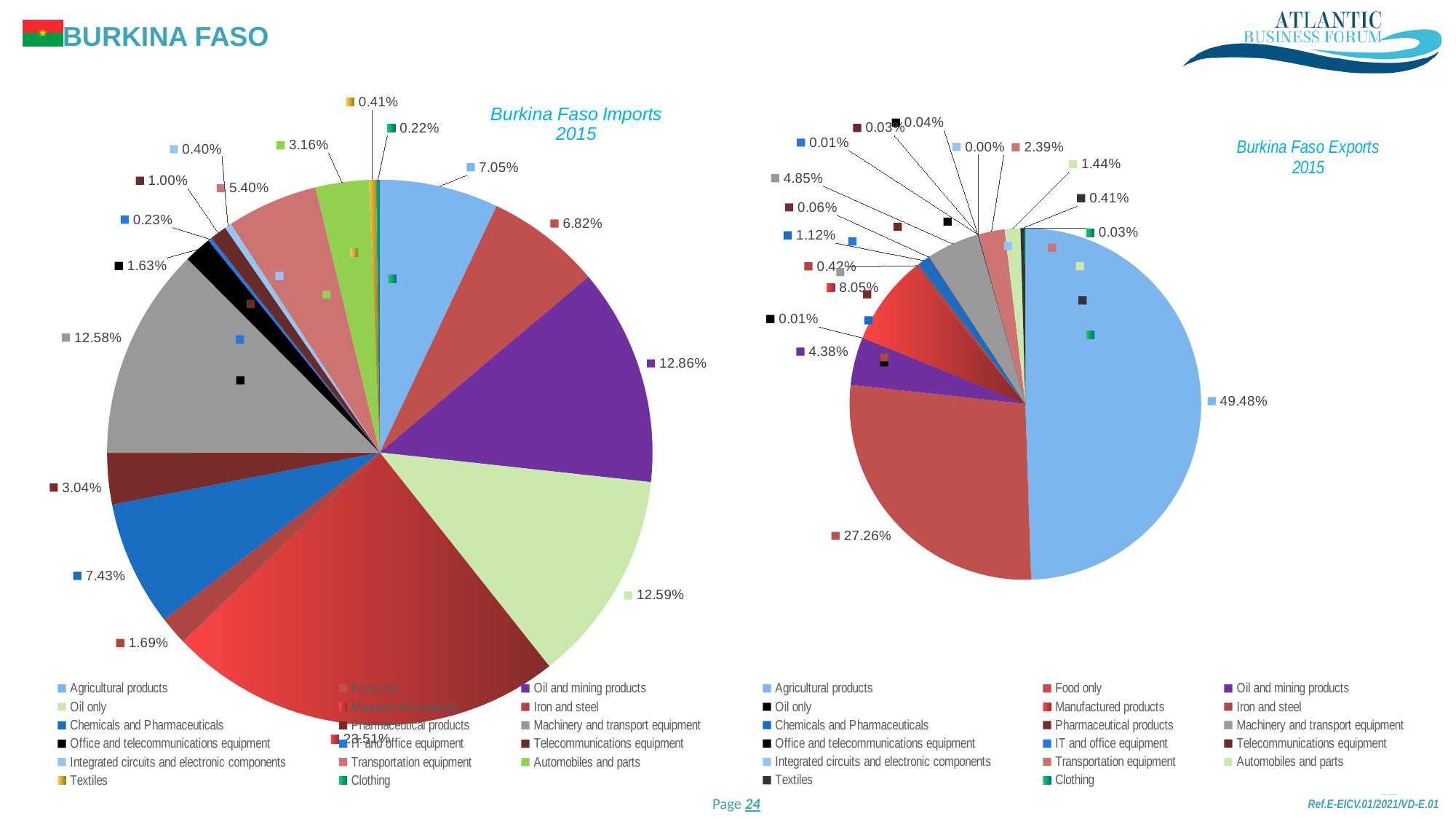
In the Burkina Faso Imports 2015 chart, what share do Chemicals and Pharmaceuticals have? 7.43% In the Burkina Faso Exports 2015 chart, how many percentage points larger is the Agricultural products share than the Food only share? 22.22 In the Burkina Faso Exports 2015 chart, what share do Agricultural products have? 49.48% In the Burkina Faso Exports 2015 chart, which is larger: Machinery and transport equipment or Oil and mining products? Machinery and transport equipment In the Burkina Faso Exports 2015 chart, what share do Manufactured products have? 8.05% In the Burkina Faso Exports 2015 chart, which category has the largest share? Agricultural products In the Burkina Faso Exports 2015 chart, what share does Food only have? 27.26% In the Burkina Faso Imports 2015 chart, what share does Machinery and transport equipment have? 12.58% In the Burkina Faso Imports 2015 chart, which is larger: the share of Oil and mining products or the share of Oil only? Oil and mining products What kind of chart is the Burkina Faso Imports 2015 chart? Pie chart How many categories does the legend of the Burkina Faso Exports 2015 chart list? 17 In the Burkina Faso Imports 2015 chart, what share do Oil and mining products have? 12.86%